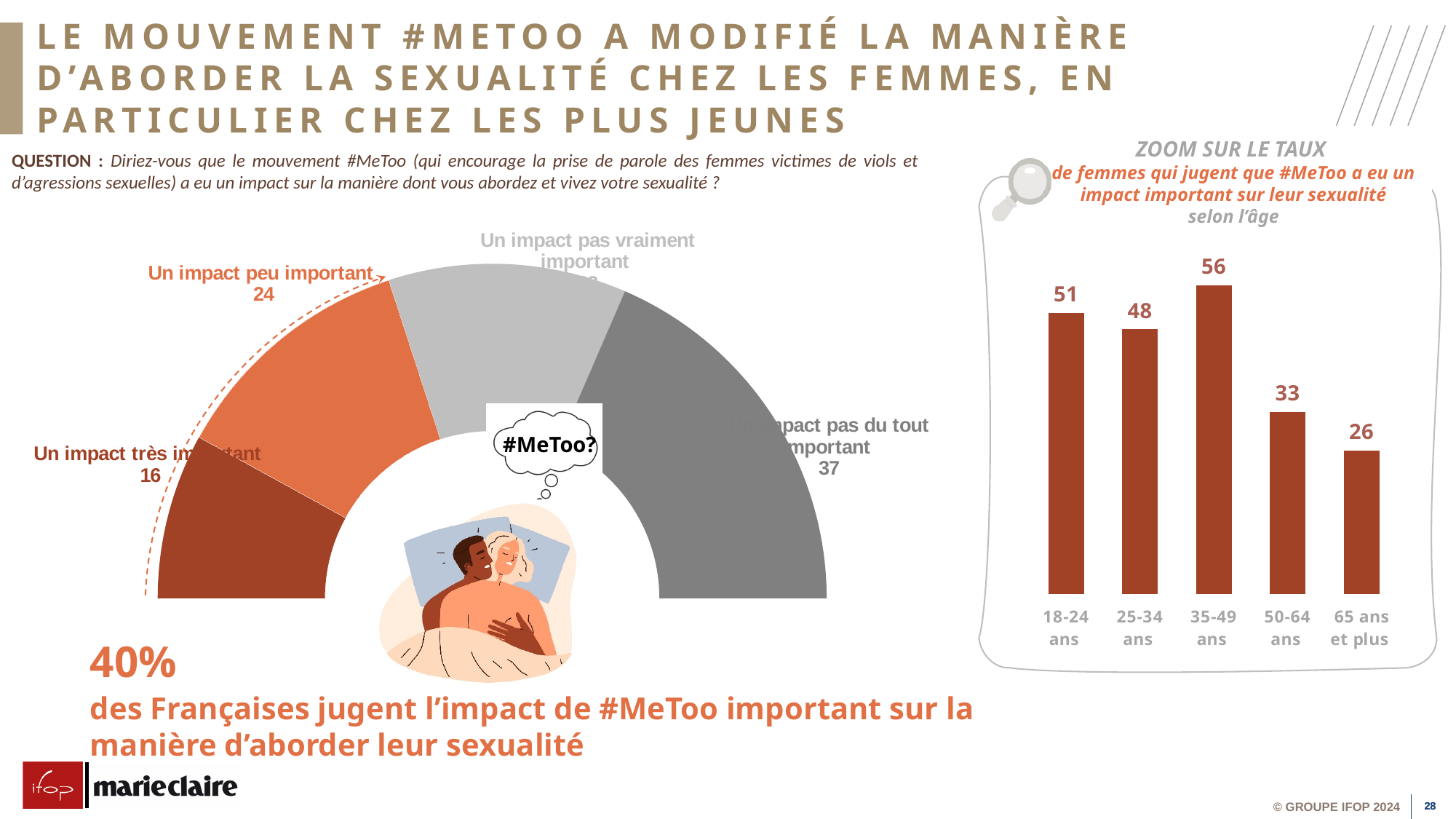
In the bar chart on the right (zoom by age), what is the value for 65 ans et plus? 26 In the semicircle chart on the left, what is the difference between 'Un impact pas du tout important' and 'Un impact peu important'? 13 In the bar chart on the right (zoom by age), what is the value for 18-24 ans? 51 What kind of chart is the chart on the right (zoom by age)? bar chart In the semicircle chart on the left, what is the value for 'Un impact pas du tout important'? 37 In the bar chart on the right, do the values rise or fall from 35-49 ans to 65 ans et plus? fall In the bar chart on the right (zoom by age), which is larger: the value for 18-24 ans or 25-34 ans? 18-24 ans In the bar chart on the right (zoom by age), what is the difference between the values for 35-49 ans and 50-64 ans? 23 In the bar chart on the right (zoom by age), which age group has the lowest value? 65 ans et plus How many age groups are shown in the bar chart on the right? 5 In the bar chart on the right (zoom by age), which age group has the highest value? 35-49 ans In the semicircle chart on the left, what is the value for 'Un impact très important'? 16